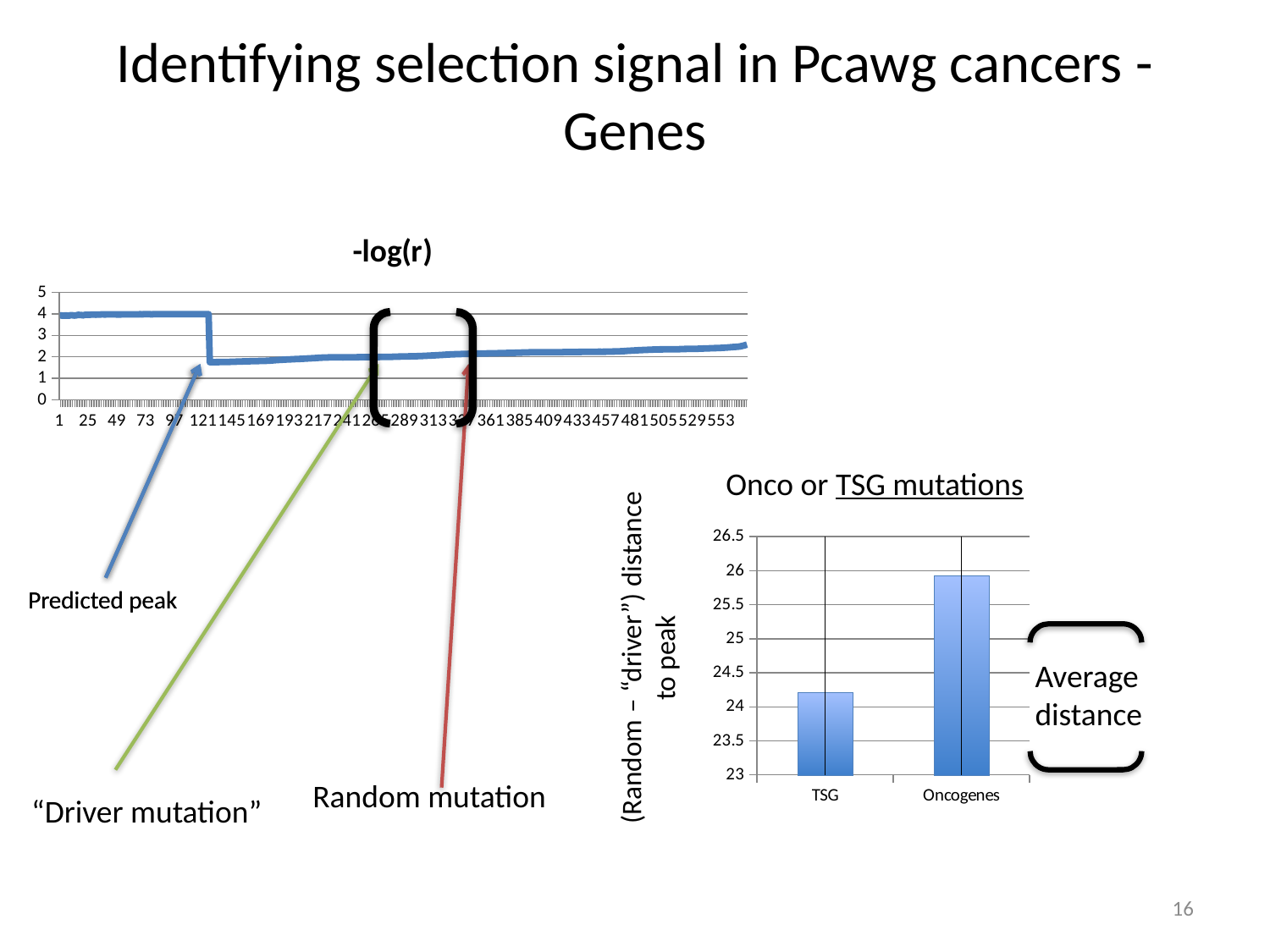
What kind of chart is the chart titled "-log(r)"? line chart In the chart titled "Onco or TSG mutations", which category has the lowest bar? TSG In the chart titled "Onco or TSG mutations", is the value for TSG greater or less than 24.5? less In the chart titled "Onco or TSG mutations", which is larger, the value for TSG or the value for Oncogenes? Oncogenes In the chart titled "-log(r)", is the value at x = 1 greater or less than 3? greater In the chart titled "-log(r)", is the value at x = 553 greater or less than 3? less What is the y-axis label of the chart titled "Onco or TSG mutations"? (Random – "driver") distance to peak What kind of chart is the chart titled "Onco or TSG mutations"? bar chart In the chart titled "Onco or TSG mutations", how many categories are shown on the x axis? 2 In the chart titled "Onco or TSG mutations", which category has the highest bar? Oncogenes